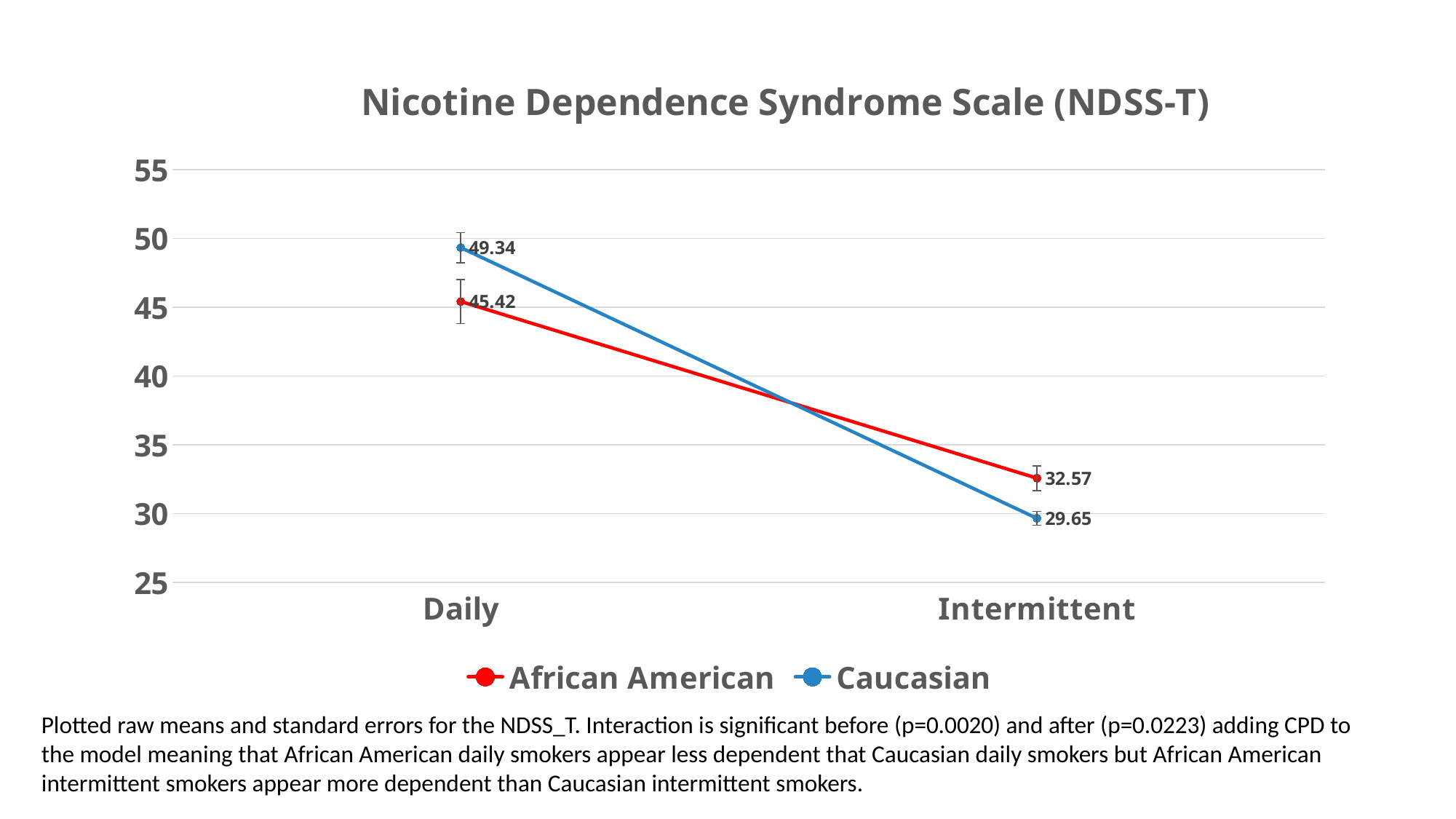
What is the NDSS-T value for African American intermittent smokers? 32.57 How many series does the legend list? 2 What is the difference between the Caucasian and African American values for daily smokers? 3.92 Do the values for the Caucasian series rise or fall from Daily to Intermittent? Fall What is the NDSS-T value for African American daily smokers? 45.42 What is the NDSS-T value for Caucasian intermittent smokers? 29.65 Which group has the highest NDSS-T value on the chart? Caucasian daily smokers What kind of chart is shown on the slide? Line chart What is the NDSS-T value for Caucasian daily smokers? 49.34 What is the difference between the African American and Caucasian values for intermittent smokers? 2.92 Which group has the lowest NDSS-T value on the chart? Caucasian intermittent smokers For intermittent smokers, which series has the larger value, African American or Caucasian? African American